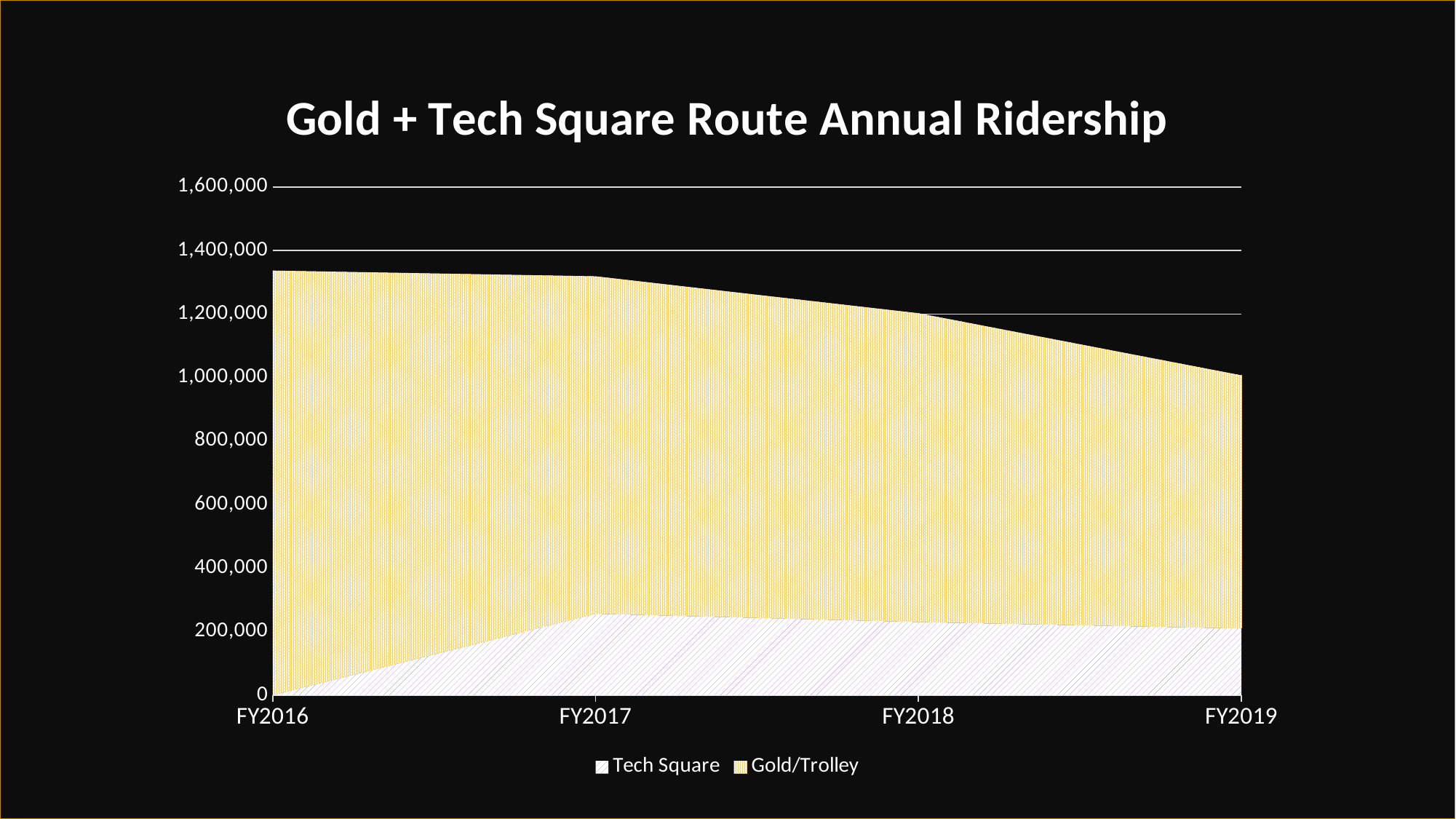
Which fiscal year has the highest total ridership? FY2016 Is the total ridership in FY2016 greater or less than 1,200,000? greater Is the Tech Square ridership in FY2016 greater or less than 200,000? less Is the total ridership in FY2018 greater or less than 1,400,000? less What kind of chart is shown on the slide? area chart What is the title of the chart? Gold + Tech Square Route Annual Ridership Does the total ridership (top of the stacked area) rise or fall from FY2016 to FY2019? fall How many fiscal years are shown on the x axis? 4 Which two series are listed in the legend? Tech Square and Gold/Trolley How many series does the legend list? 2